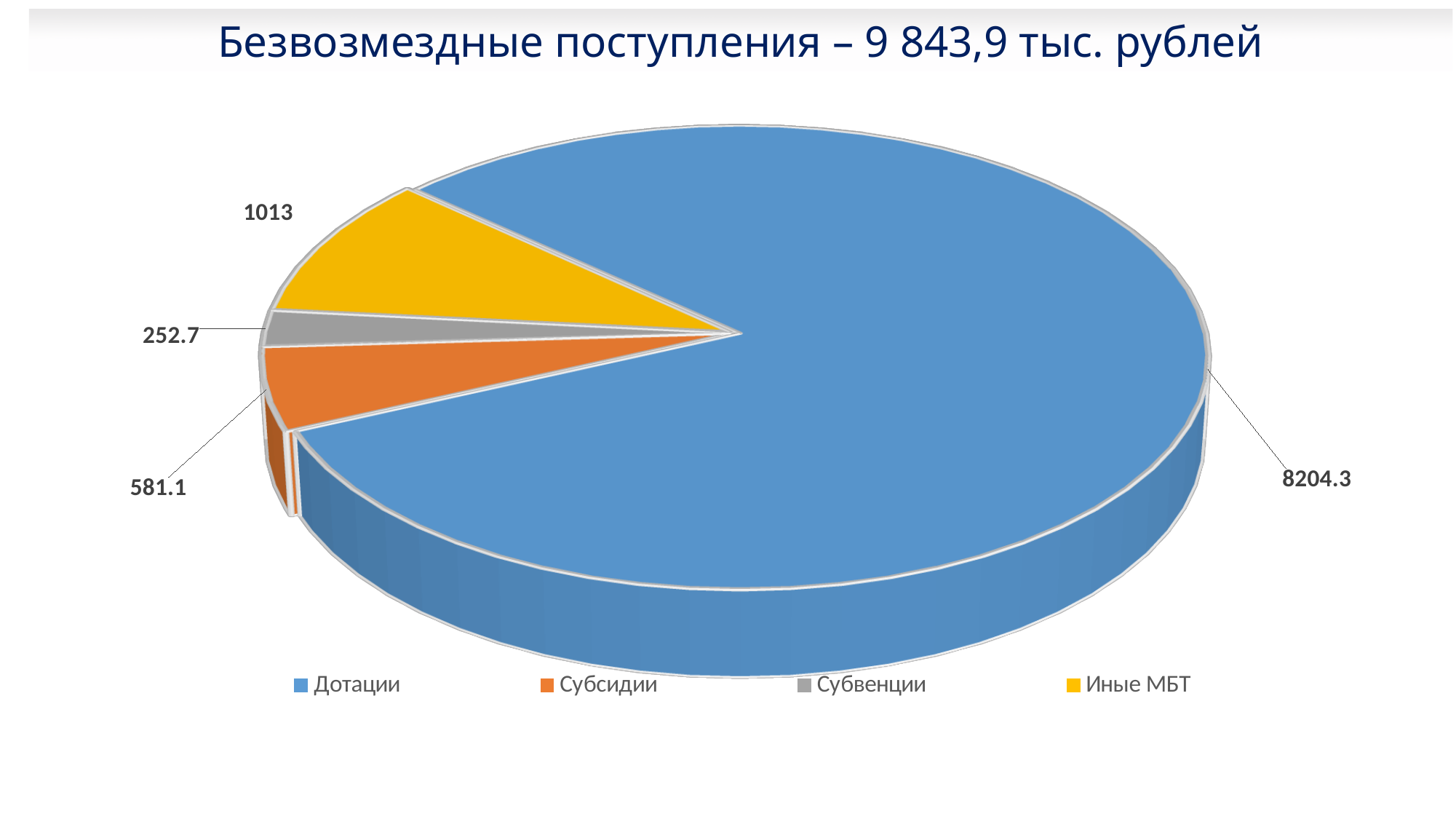
What is the value for Субвенции? 252.7 What is the value for Субсидии? 581.1 Which category has the largest slice of the pie? Дотации What is the difference between the values for Иные МБТ and Субсидии? 431.9 What is the value for Иные МБТ? 1013 How many categories does the pie chart have? 4 What is the title of the chart on the slide? Безвозмездные поступления – 9 843,9 тыс. рублей Which is larger, the value for Субсидии or the value for Субвенции? Субсидии Which category has the smallest slice of the pie? Субвенции What is the difference between the values for Дотации and Иные МБТ? 7191.3 What is the value for Дотации? 8204.3 What type of chart is shown on the slide? Pie chart